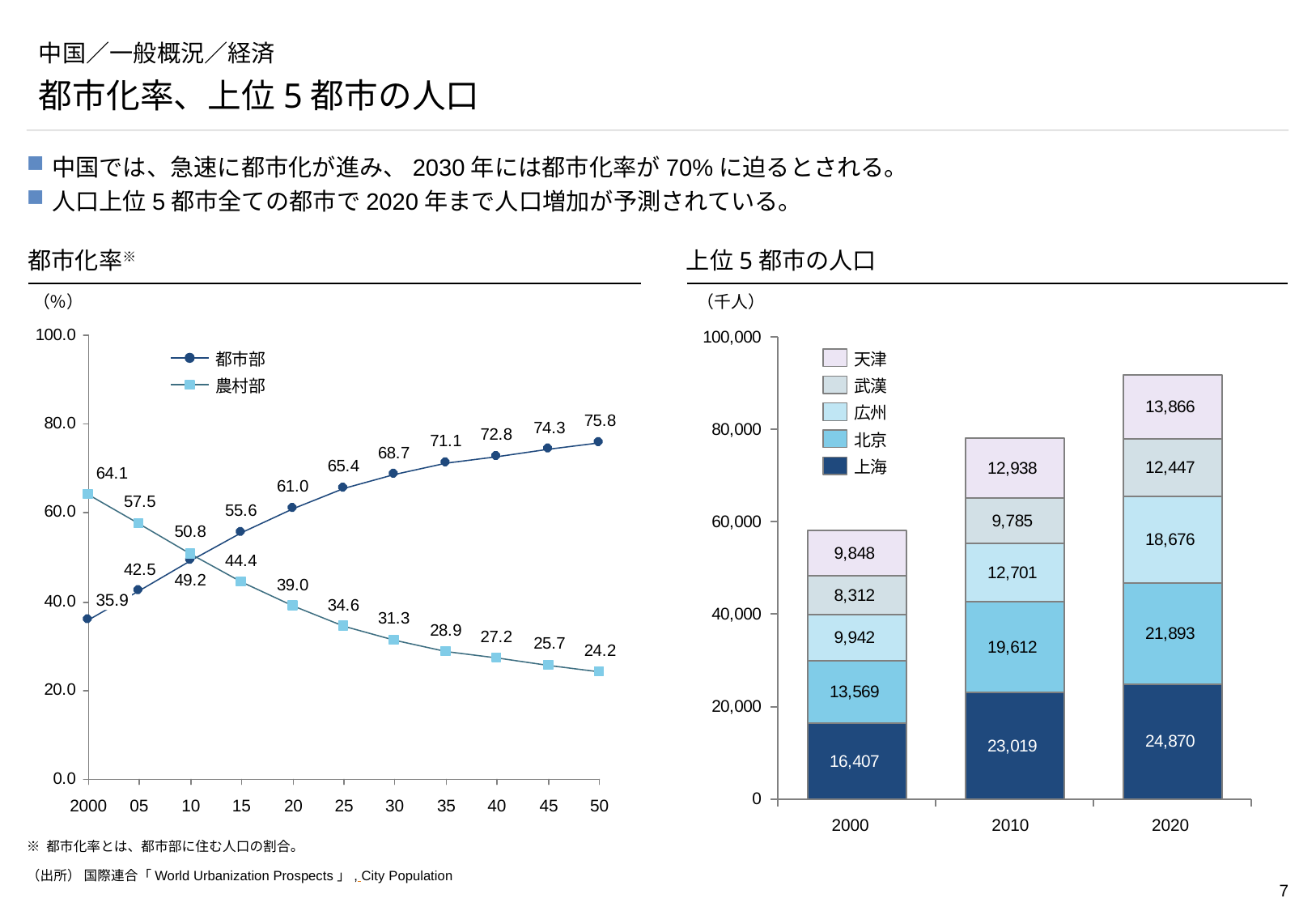
In the 都市化率 chart, how many series does the legend list? 2 In the 上位5都市の人口 chart, what is the value for 北京 in 2010? 19,612 In the 上位5都市の人口 chart, is the total for 2020 greater or less than 80,000? greater In the 都市化率 chart, what is the value for 農村部 in 2000? 64.1 In the 上位5都市の人口 chart, which is larger in 2000: 広州 or 天津? 広州 In the 都市化率 chart, does the 都市部 series rise or fall from 2000 to 2050? rise In the 都市化率 chart, what is the difference between the 都市部 and 農村部 values in 2050? 51.6 What kind of chart is the 上位5都市の人口 chart? stacked bar chart In the 上位5都市の人口 chart, which city has the largest value in 2020? 上海 In the 都市化率 chart, how many data points are plotted for each series? 11 In the 上位5都市の人口 chart, what is the total of the stacked bar for 2000? 58,078 In the 都市化率 chart, what is the value for 都市部 in 2030? 68.7